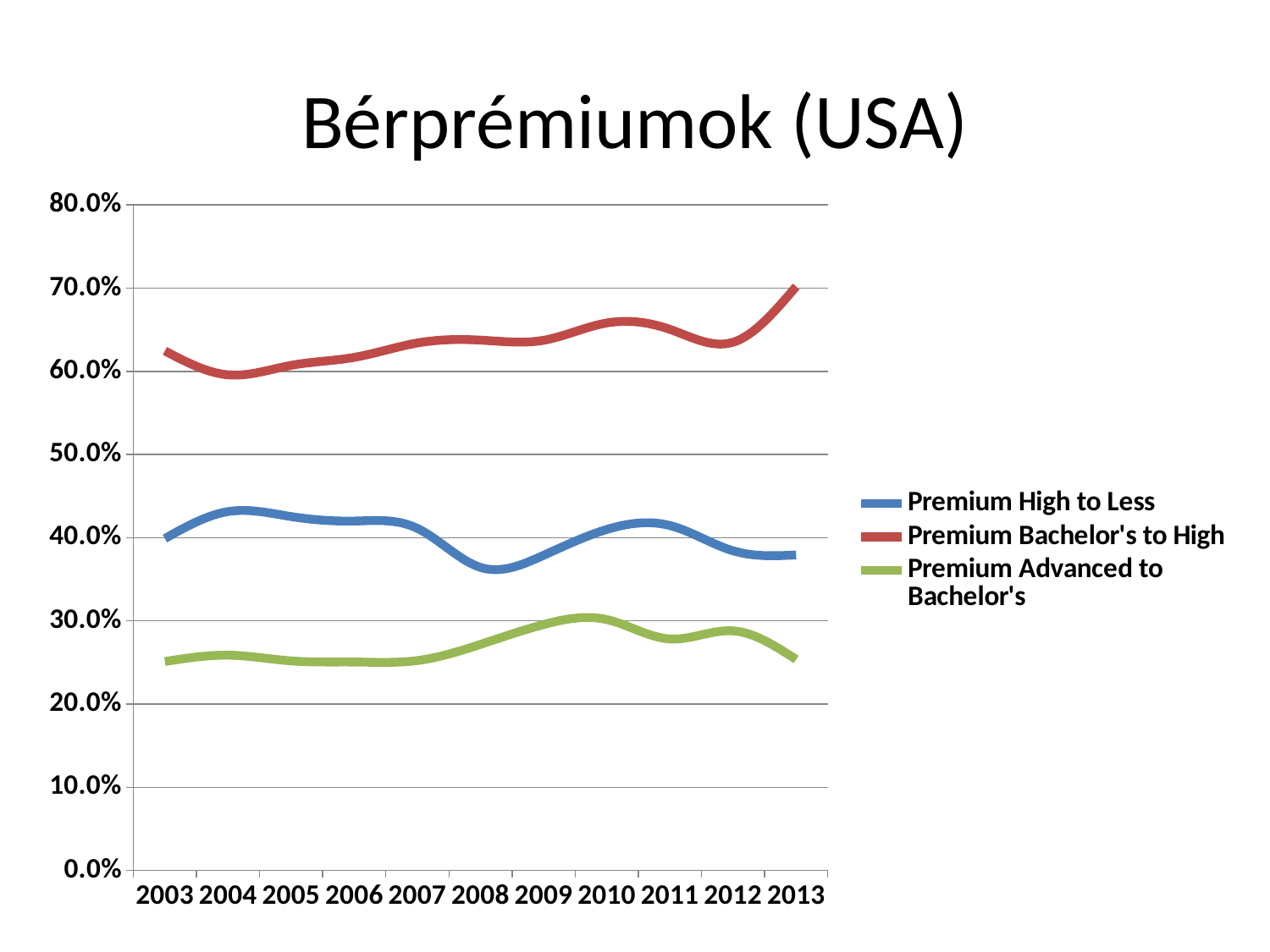
Is the value for Premium Advanced to Bachelor's in 2003 greater or less than 30.0%? less Is the value for Premium Bachelor's to High in 2013 greater or less than 60.0%? greater Does Premium Bachelor's to High rise or fall from 2012 to 2013? rise Which series has the highest values across all years? Premium Bachelor's to High Which series is drawn in red? Premium Bachelor's to High How many years are plotted along the x axis? 11 In which year does Premium Bachelor's to High reach its highest value? 2013 Is the value for Premium High to Less in 2008 greater or less than 40.0%? less What is the title of the chart? Bérprémiumok (USA) How many series does the legend list? 3 What kind of chart is shown on the slide? line chart In 2013, which is higher: Premium High to Less or Premium Advanced to Bachelor's? Premium High to Less